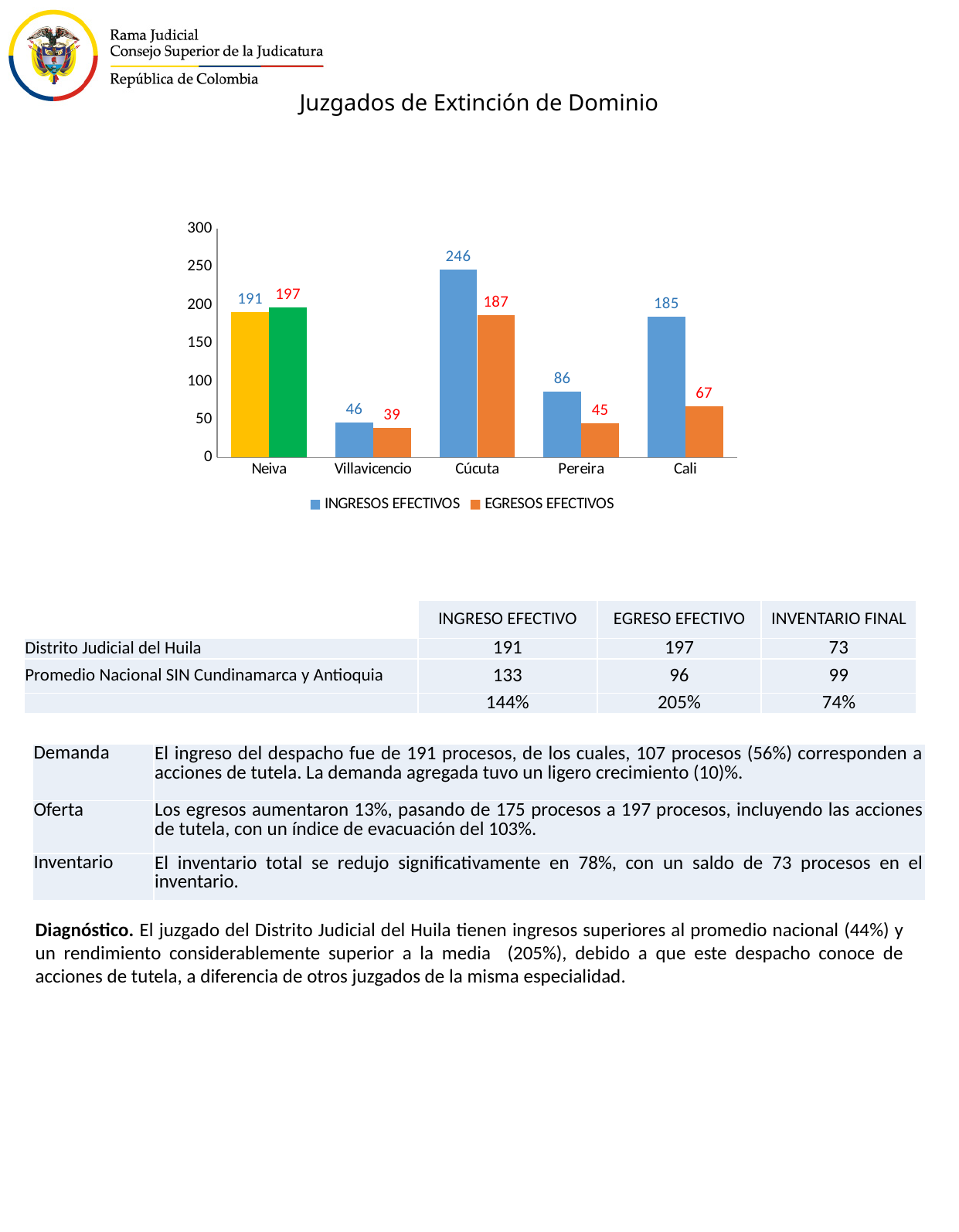
Is the INGRESOS EFECTIVOS value for Pereira greater or less than 100? less Which city has the lowest EGRESOS EFECTIVOS value? Villavicencio How many cities are shown on the x axis of the chart? 5 What is the difference between the INGRESOS EFECTIVOS values of Cúcuta and Villavicencio? 200 Which is larger for Neiva, INGRESOS EFECTIVOS or EGRESOS EFECTIVOS? EGRESOS EFECTIVOS What is the EGRESOS EFECTIVOS value for Neiva? 197 Which city has the highest INGRESOS EFECTIVOS value? Cúcuta What is the difference between INGRESOS EFECTIVOS and EGRESOS EFECTIVOS for Cali? 118 What is the EGRESOS EFECTIVOS value for Pereira? 45 What is the INGRESOS EFECTIVOS value for Cúcuta? 246 What kind of chart is shown on the slide? bar chart How many series does the chart legend list? 2